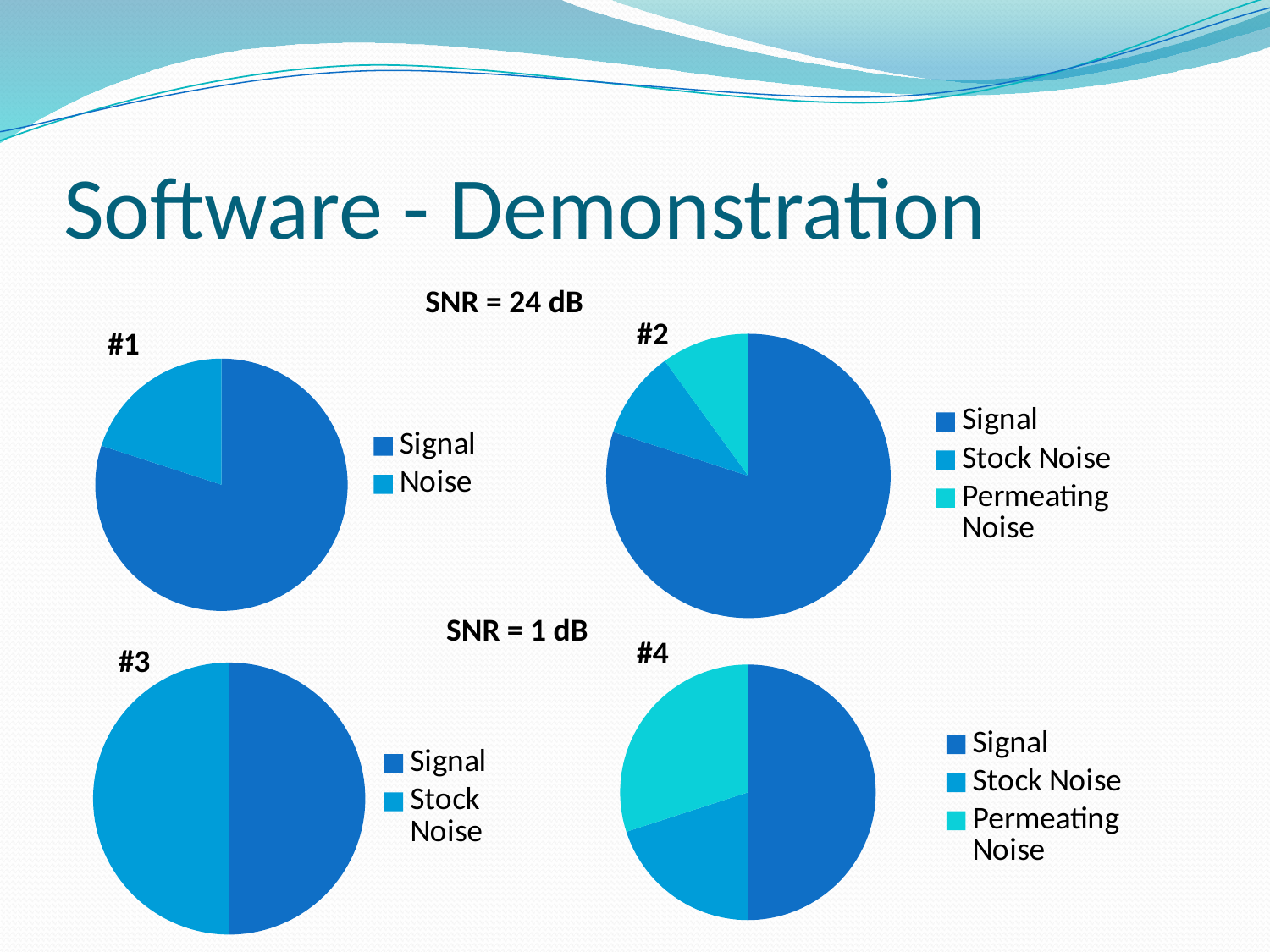
How many entries does the legend of chart #4 list? 3 In chart #4, which slice is the largest? Signal What SNR value is shown above charts #3 and #4? SNR = 1 dB In chart #2, which slice is the largest? Signal In chart #1, which is larger, Signal or Noise? Signal How many entries does the legend of chart #1 list? 2 What SNR value is shown above charts #1 and #2? SNR = 24 dB In chart #4, which slice is the smallest? Stock Noise In chart #4, which is larger, Permeating Noise or Stock Noise? Permeating Noise What kind of chart is chart #1? Pie chart How many slices does chart #2 have? 3 In chart #1, which slice is the largest? Signal